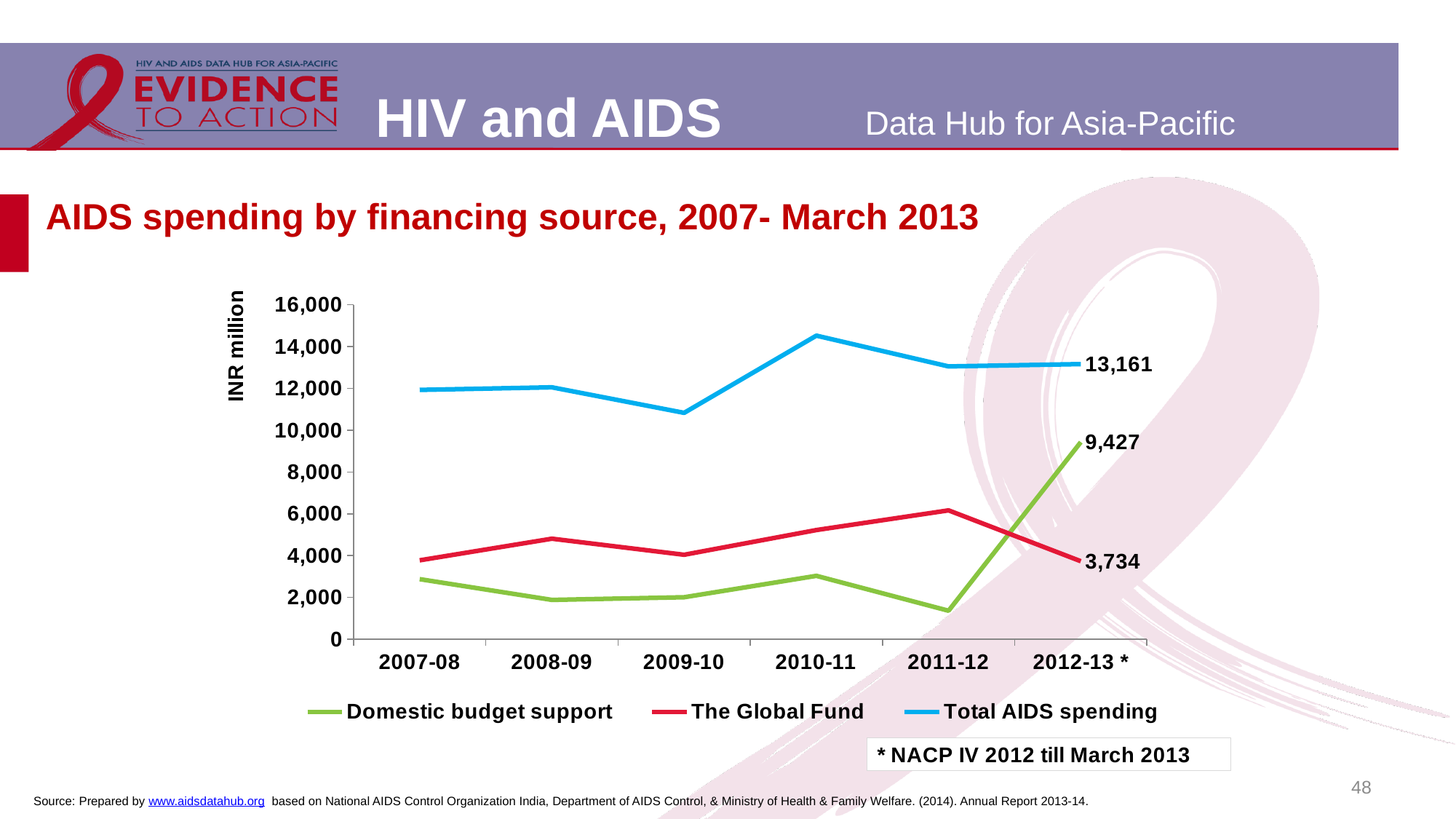
Is the value for Total AIDS spending in 2009-10 greater or less than 12,000? less What kind of chart is shown on the slide? line chart What is the value of The Global Fund in 2012-13 *? 3,734 What is the label on the y axis? INR million In 2012-13 *, which is larger: Domestic budget support or The Global Fund? Domestic budget support What is the difference between Domestic budget support and The Global Fund in 2012-13 *? 5,693 How many series does the legend list? 3 How many time periods are shown on the x axis? 6 What is the value of Domestic budget support in 2012-13 *? 9,427 What is the value of Total AIDS spending in 2012-13 *? 13,161 Does Domestic budget support rise or fall between 2011-12 and 2012-13 *? rise In which period is Total AIDS spending highest? 2010-11